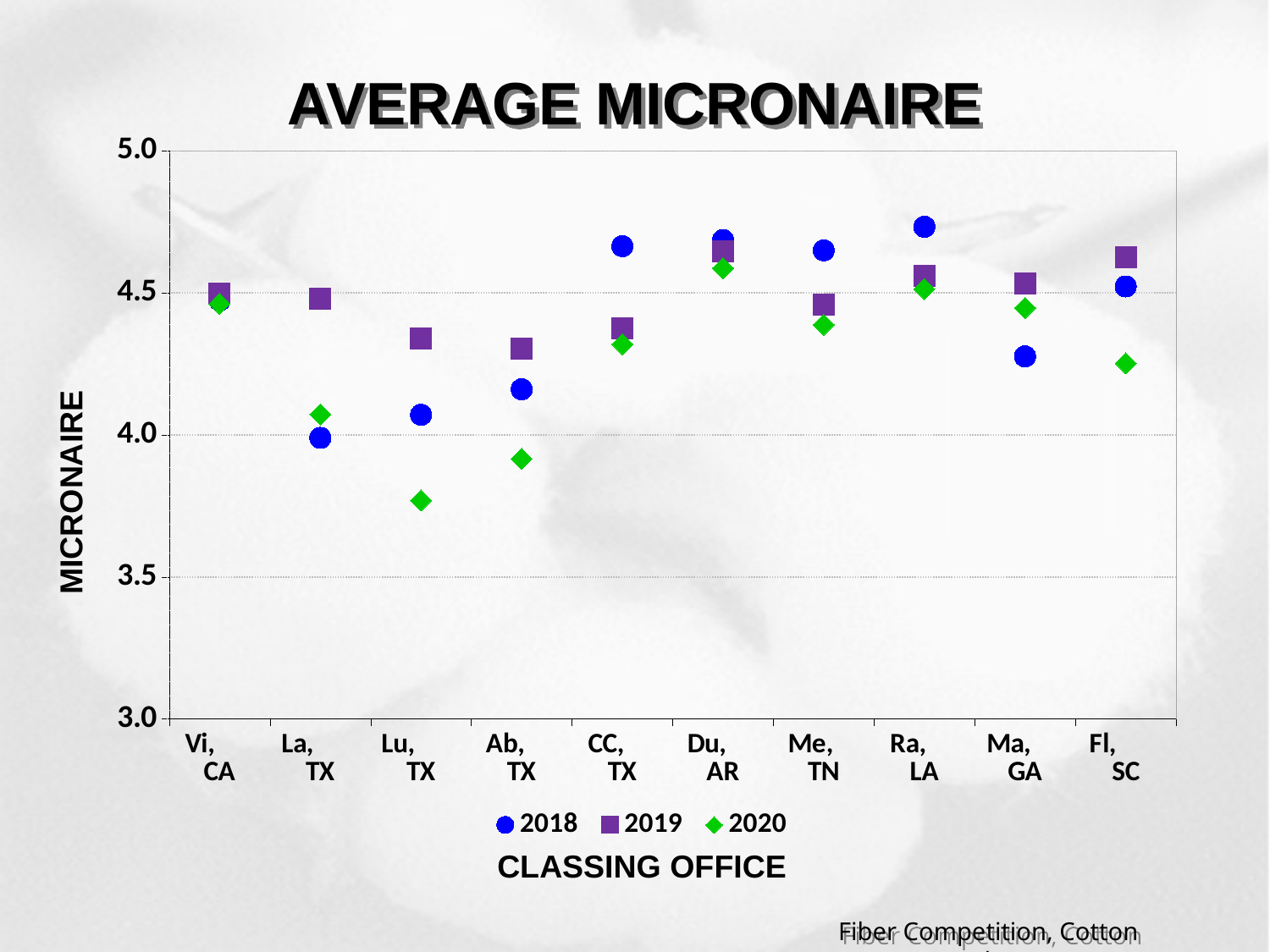
For Ma, GA, which is larger: the 2018 value or the 2019 value? 2019 For Fl, SC, which is larger: the 2018 value or the 2020 value? 2018 How many series does the legend list? 3 What kind of chart is this? Scatter (dot) chart What is the title of the chart? AVERAGE MICRONAIRE Which classing office has the lowest 2020 value? Lu, TX Is the 2018 value for CC, TX greater or less than 4.5? greater Is the 2020 value for Ab, TX greater or less than 4.0? less Is the 2020 value for Fl, SC greater or less than 4.5? less What is the label of the x axis? CLASSING OFFICE How many classing offices are shown on the x axis? 10